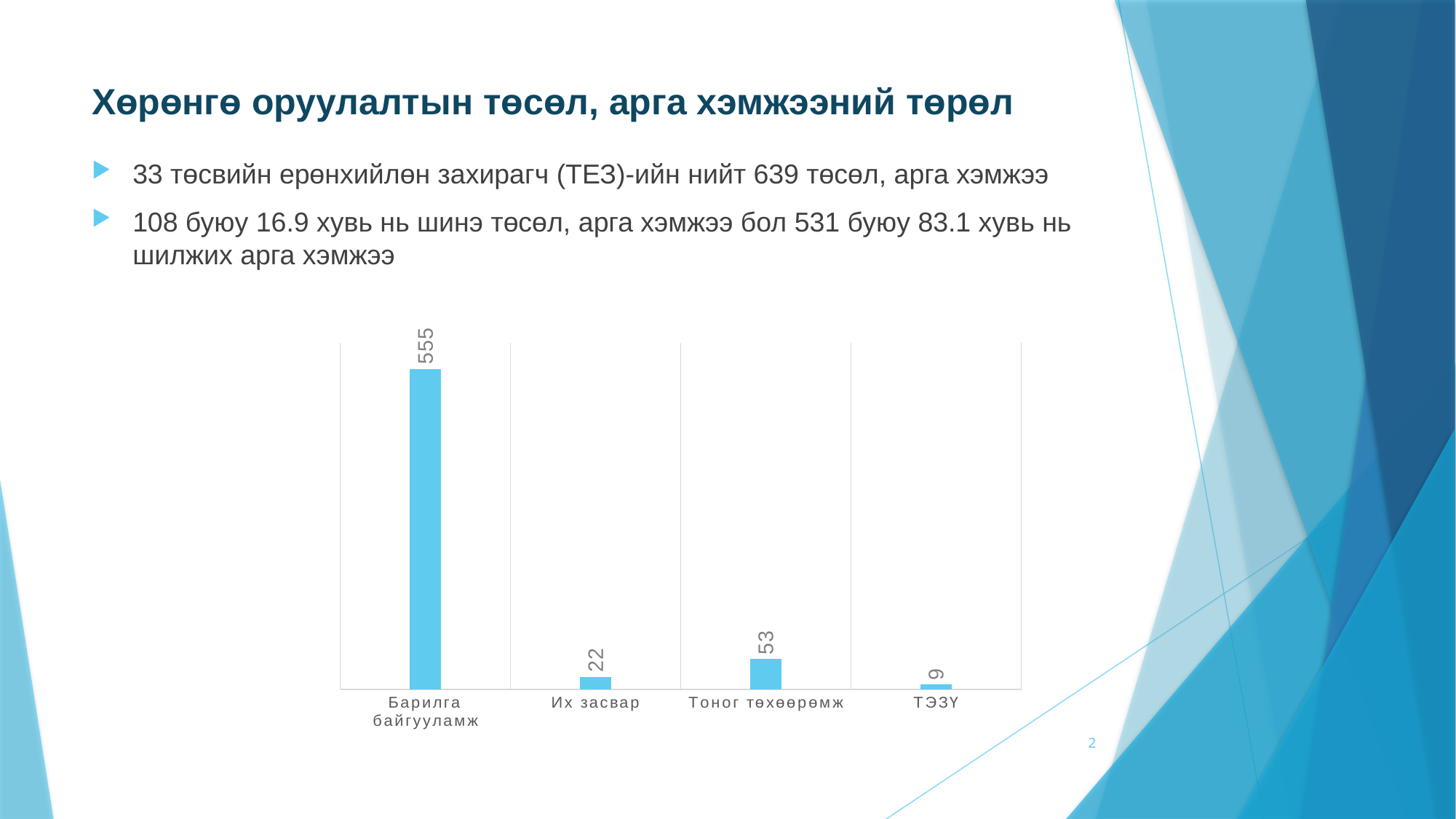
Which category has the highest value? Барилга байгууламж What is the value for Барилга байгууламж? 555 What colour are the bars in the chart? Light blue What kind of chart is shown on the slide? Bar chart Which category has the lowest value? ТЭЗҮ What is the value for Их засвар? 22 What is the difference between the values for Тоног төхөөрөмж and Их засвар? 31 Which is larger, the value for Их засвар or the value for Тоног төхөөрөмж? Тоног төхөөрөмж What is the difference between the values for Барилга байгууламж and Тоног төхөөрөмж? 502 What is the value for ТЭЗҮ? 9 What is the value for Тоног төхөөрөмж? 53 How many categories are shown in the chart? 4